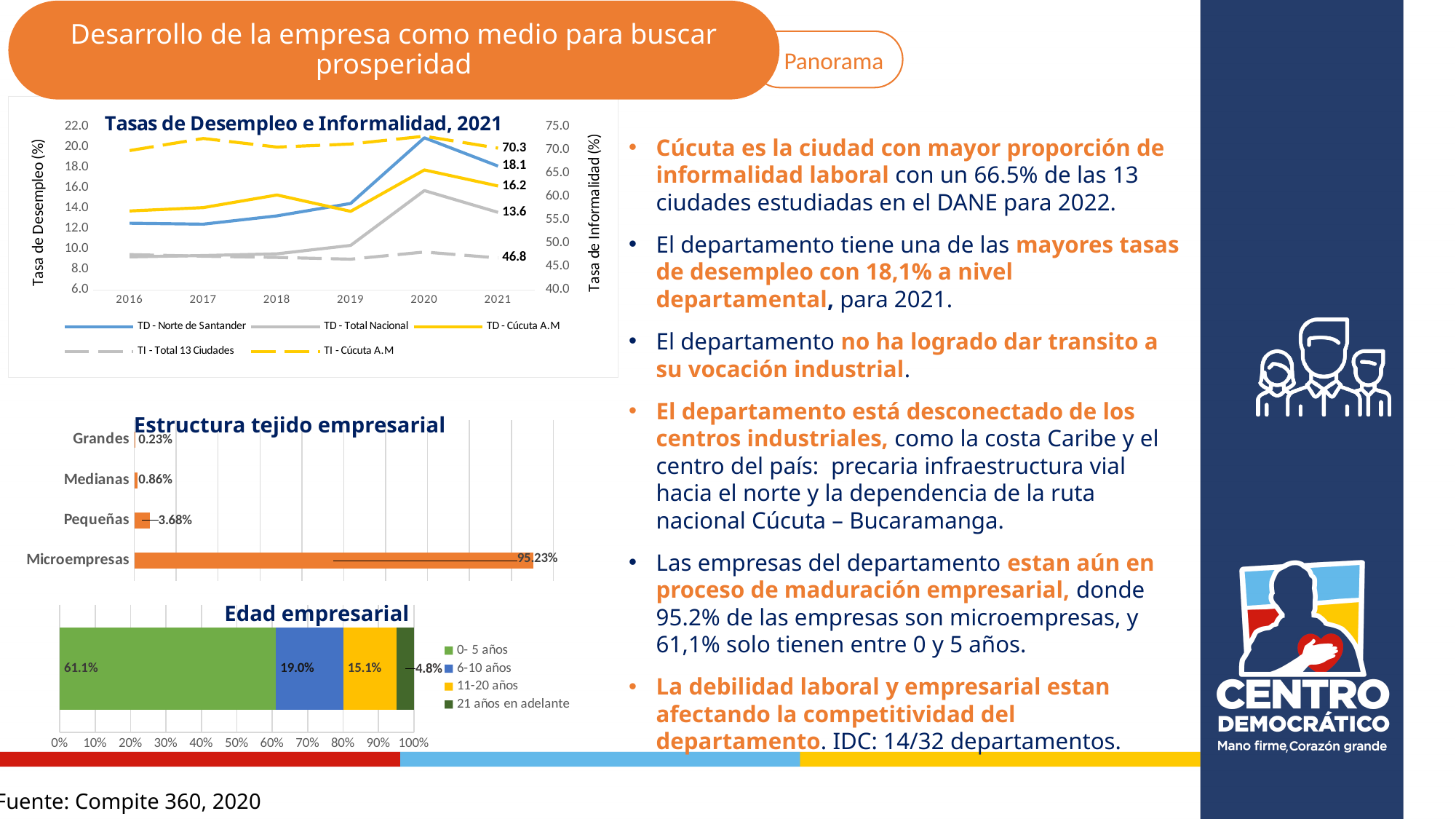
In the 'Estructura tejido empresarial' chart, which category has the lowest value? Grandes In the 'Tasas de Desempleo e Informalidad, 2021' chart, how many series does the legend list? 5 In the 'Edad empresarial' chart, which is larger, 11-20 años or 21 años en adelante? 11-20 años In the 'Estructura tejido empresarial' chart, what is the value for Pequeñas? 3.68% In the 'Tasas de Desempleo e Informalidad, 2021' chart, what is the 2021 value for TI - Cúcuta A.M? 70.3 In the 'Tasas de Desempleo e Informalidad, 2021' chart, what is the 2021 value for TD - Norte de Santander? 18.1 In the 'Tasas de Desempleo e Informalidad, 2021' chart, what is the difference between the 2021 values of TD - Norte de Santander and TD - Cúcuta A.M? 1.9 In the 'Tasas de Desempleo e Informalidad, 2021' chart, what kind of chart is it? Line chart In the 'Estructura tejido empresarial' chart, which category has the highest value? Microempresas In the 'Tasas de Desempleo e Informalidad, 2021' chart, what is the 2021 value for TD - Total Nacional? 13.6 In the 'Tasas de Desempleo e Informalidad, 2021' chart, how many years are shown on the x axis? 6 In the 'Edad empresarial' chart, what is the value for 6-10 años? 19.0%